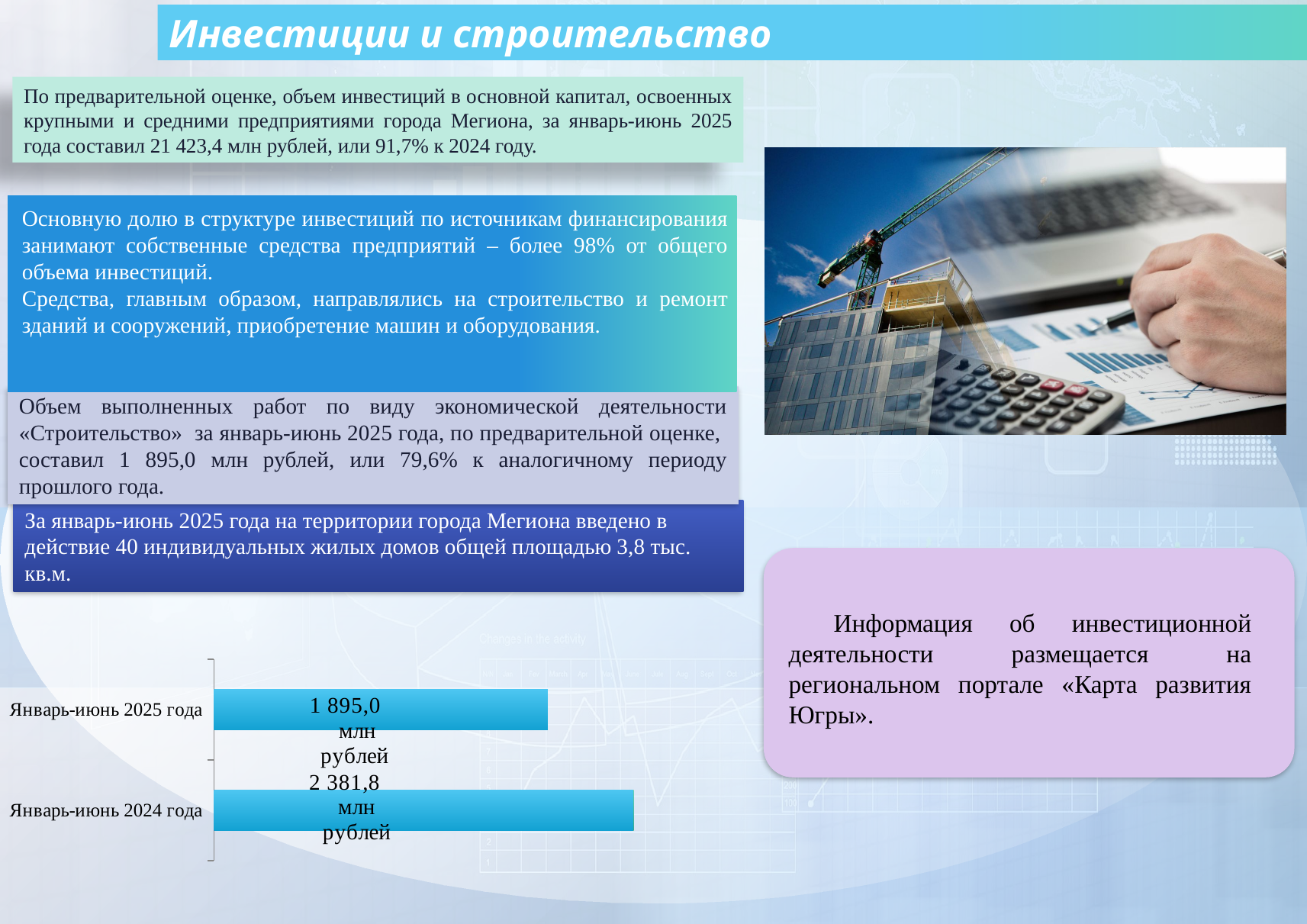
Is the bar for Январь-июнь 2025 года longer or shorter than the bar for Январь-июнь 2024 года? shorter What type of chart is shown at the bottom left of the slide? bar chart Did the value decrease or increase from Январь-июнь 2024 года to Январь-июнь 2025 года according to the bar chart? decrease Which period has the higher value on the bar chart? Январь-июнь 2024 года Are the bars in the chart oriented horizontally or vertically? horizontally What colour are the bars in the bar chart? blue Which period has the lower value on the bar chart? Январь-июнь 2025 года What is the difference between the values for Январь-июнь 2024 года and Январь-июнь 2025 года on the bar chart? 486,8 млн рублей What is the value shown for Январь-июнь 2024 года on the bar chart? 2 381,8 млн рублей How many categories (bars) does the bar chart show? 2 What is the value shown for Январь-июнь 2025 года on the bar chart? 1 895,0 млн рублей